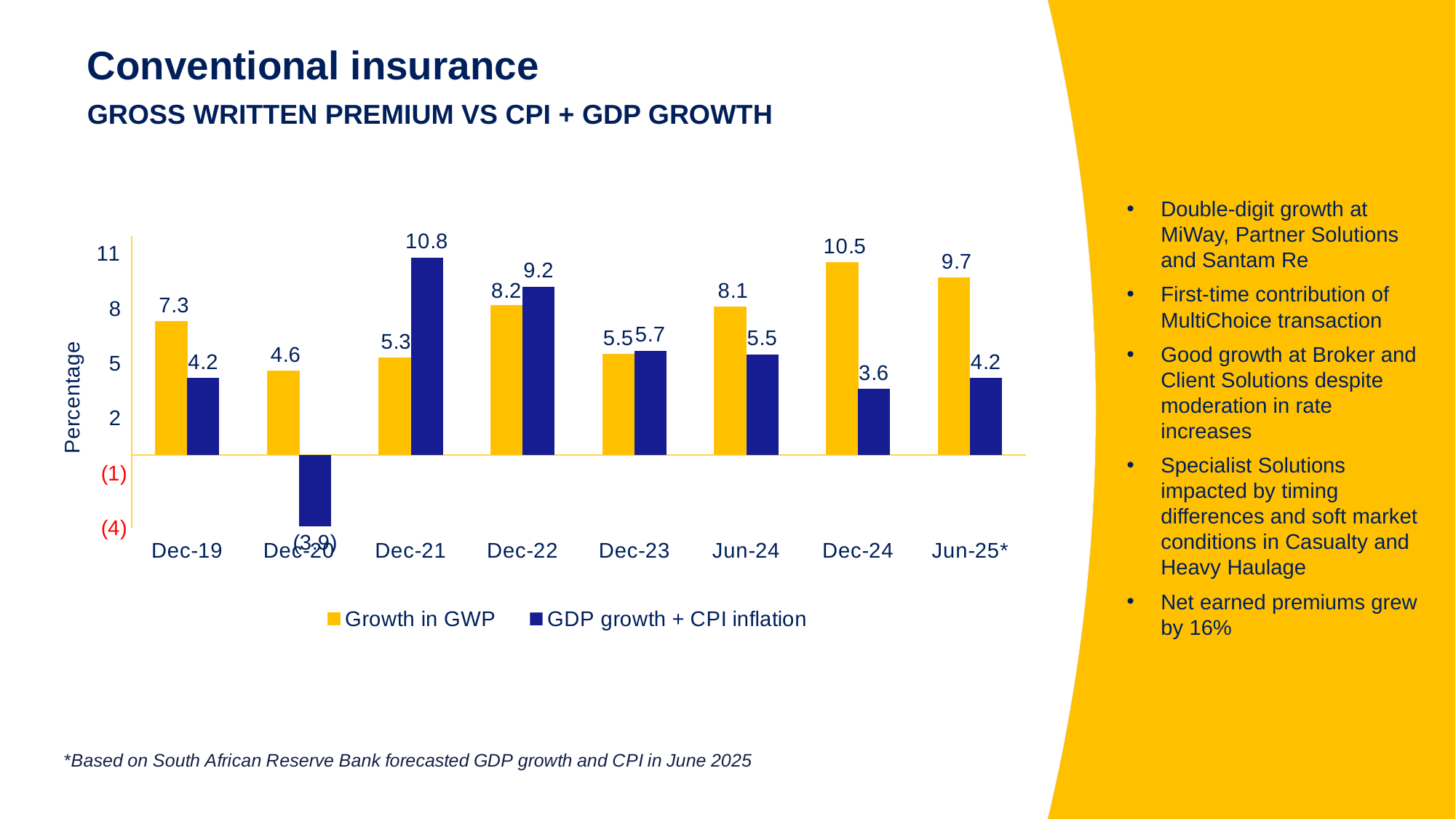
How many series does the legend list? 2 What is the Growth in GWP value for Jun-25*? 9.7 Which period has the highest Growth in GWP? Dec-24 What kind of chart is shown on the slide? Bar chart How many periods are shown on the x axis of the chart? 8 Which period has the lowest GDP growth + CPI inflation value? Dec-20 In Dec-19, which is larger: Growth in GWP or GDP growth + CPI inflation? Growth in GWP What is the GDP growth + CPI inflation value for Dec-21? 10.8 Does Growth in GWP rise or fall from Dec-23 to Dec-24? Rise Which period has the highest GDP growth + CPI inflation value? Dec-21 What is the difference between Growth in GWP and GDP growth + CPI inflation in Dec-24? 6.9 What is the Growth in GWP value for Dec-24? 10.5